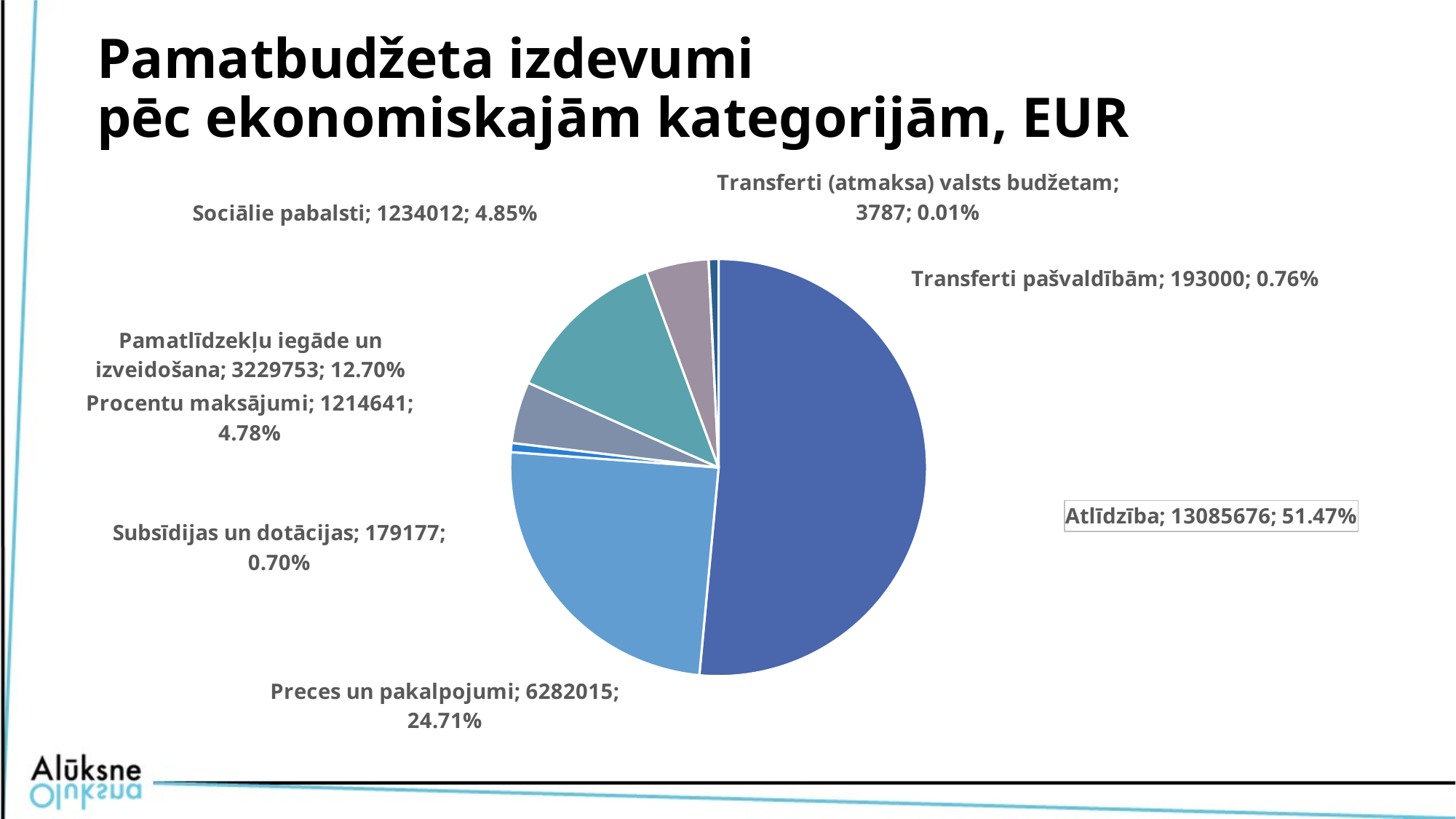
Which is larger, Transferti pašvaldībām or Subsīdijas un dotācijas? Transferti pašvaldībām Which category has the largest value? Atlīdzība How many categories does the pie chart have? 8 What is the value for Pamatlīdzekļu iegāde un izveidošana? 3229753 What is the value for Atlīdzība? 13085676 What is the title of the slide? Pamatbudžeta izdevumi pēc ekonomiskajām kategorijām, EUR What share of the pie does Procentu maksājumi represent? 4.78% What is the difference between the values for Atlīdzība and Preces un pakalpojumi? 6803661 Which category has the smallest value? Transferti (atmaksa) valsts budžetam What share of the pie does Sociālie pabalsti represent? 4.85% What is the value for Preces un pakalpojumi? 6282015 What type of chart is shown on the slide? pie chart